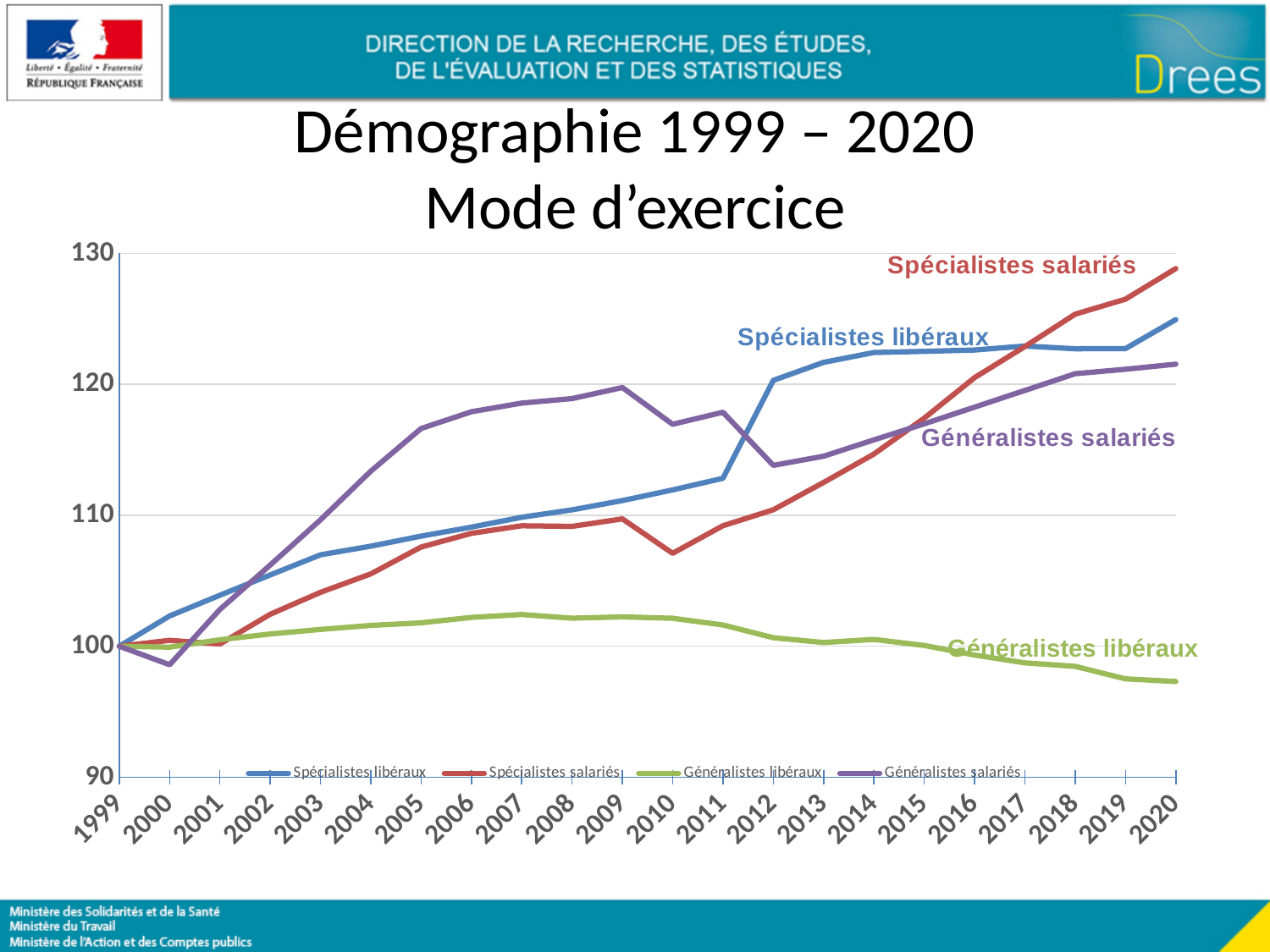
Which series has the lowest value in 2020? Généralistes libéraux How many years are shown along the x axis? 22 How many series does the legend list? 4 Is the value for Généralistes salariés in 2009 greater or less than 110? greater Which series has the highest value in 2020? Spécialistes salariés Is the value for Généralistes libéraux in 2020 greater or less than 100? less In 2005, which is larger: Généralistes salariés or Spécialistes libéraux? Généralistes salariés Does the Généralistes libéraux line rise or fall between 2009 and 2020? fall Is the value for Spécialistes salariés in 2020 greater or less than 120? greater What is the value of all four series in 1999? 100 What kind of chart is shown on the slide? line chart